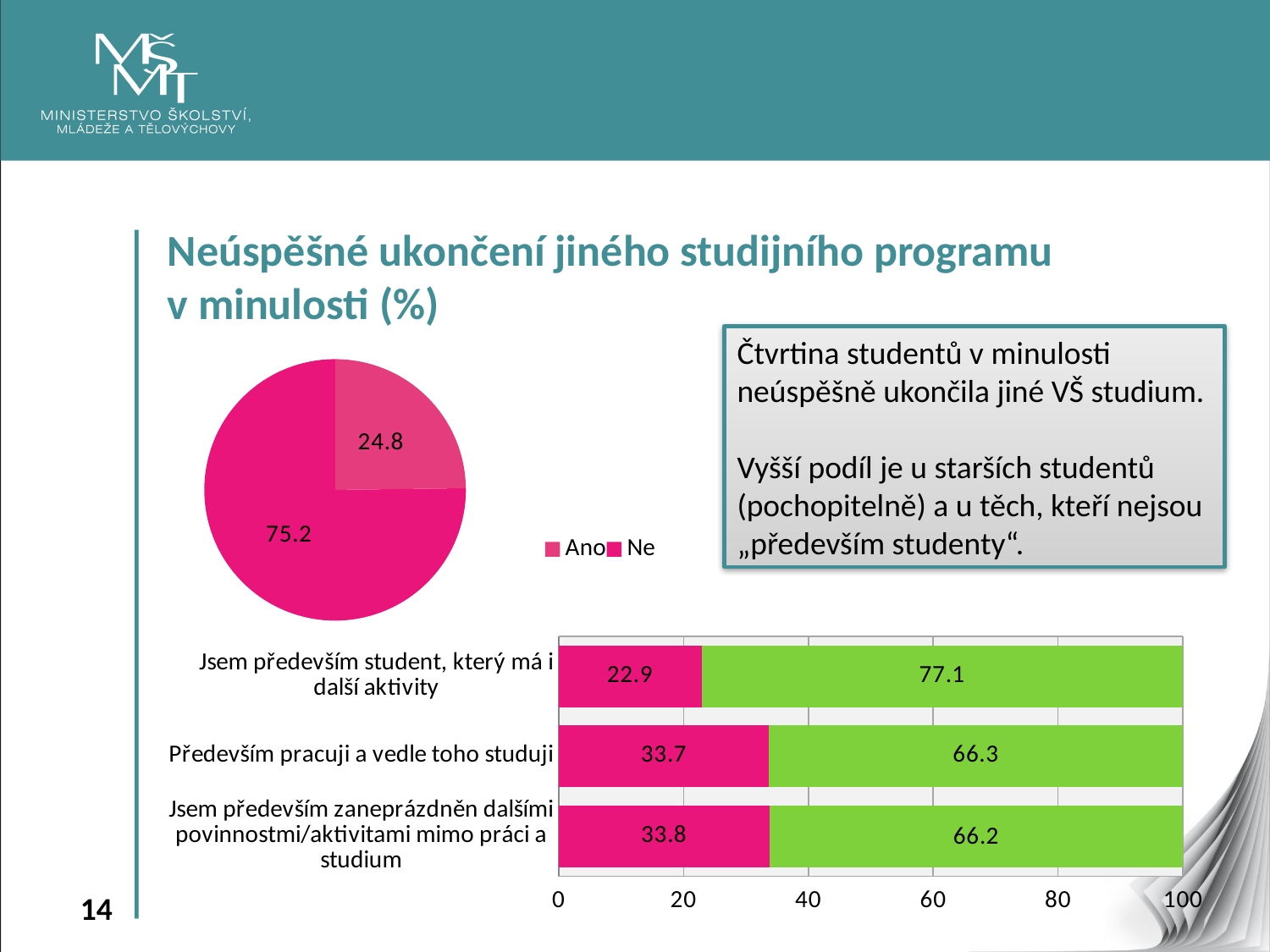
In the bar chart at the bottom, what is the difference between the green and pink segments for 'Především pracuji a vedle toho studuji'? 32.6 How many entries does the legend of the pie chart list? 2 In the pie chart, what is the value of the 'Ne' slice? 75.2 In the bar chart at the bottom, what is the value of the pink segment for 'Především pracuji a vedle toho studuji'? 33.7 In the bar chart at the bottom, what is the value of the green segment for 'Jsem především student, který má i další aktivity'? 77.1 In the pie chart, what is the value of the 'Ano' slice? 24.8 In the bar chart at the bottom, which category has the lowest pink-segment value? Jsem především student, který má i další aktivity In the pie chart, which slice is larger, 'Ano' or 'Ne'? Ne In the pie chart, what is the difference between the 'Ne' and 'Ano' values? 50.4 In the bar chart at the bottom, what is the total of the stacked bar for 'Jsem především zaneprázdněn dalšími povinnostmi/aktivitami mimo práci a studium'? 100 What kind of chart is the chart at the bottom of the slide? Stacked bar chart In the bar chart at the bottom, how many categories are shown? 3